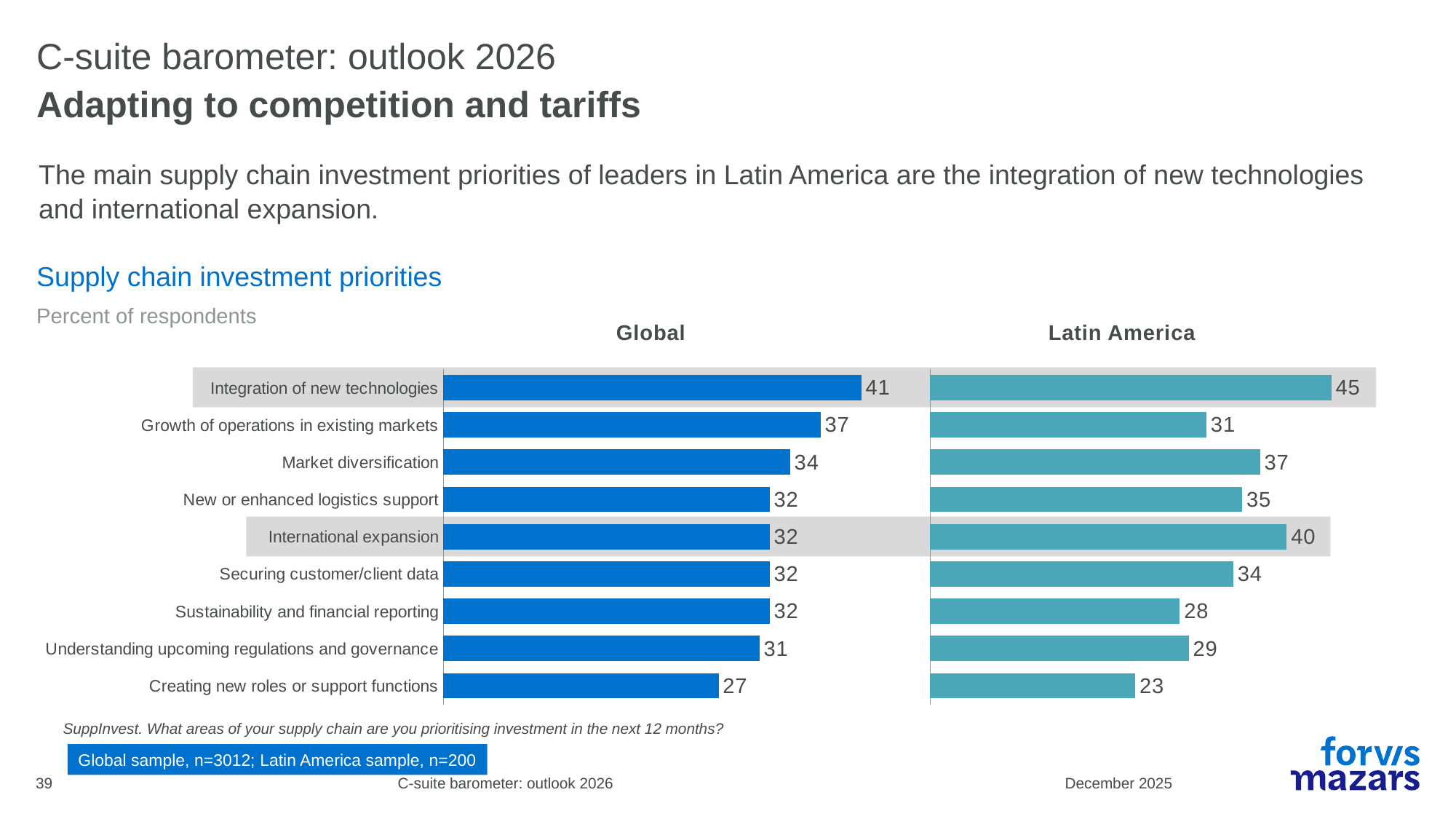
In the Latin America chart, what is the value for International expansion? 40 What type of chart is used to show the supply chain investment priorities? Bar chart In the Latin America chart, which category has the highest value? Integration of new technologies What is the difference between the Latin America and Global values for International expansion? 8 In the Latin America chart, what is the value for Creating new roles or support functions? 23 Which is larger for Market diversification: the Global value or the Latin America value? Latin America Which is larger for Growth of operations in existing markets: the Global value or the Latin America value? Global In the Global chart, what is the value for Growth of operations in existing markets? 37 In the Global chart, which category has the lowest value? Creating new roles or support functions What is the title of the chart section on the slide? Supply chain investment priorities How many categories are shown in the Global chart? 9 In the Global chart, what is the value for Integration of new technologies? 41